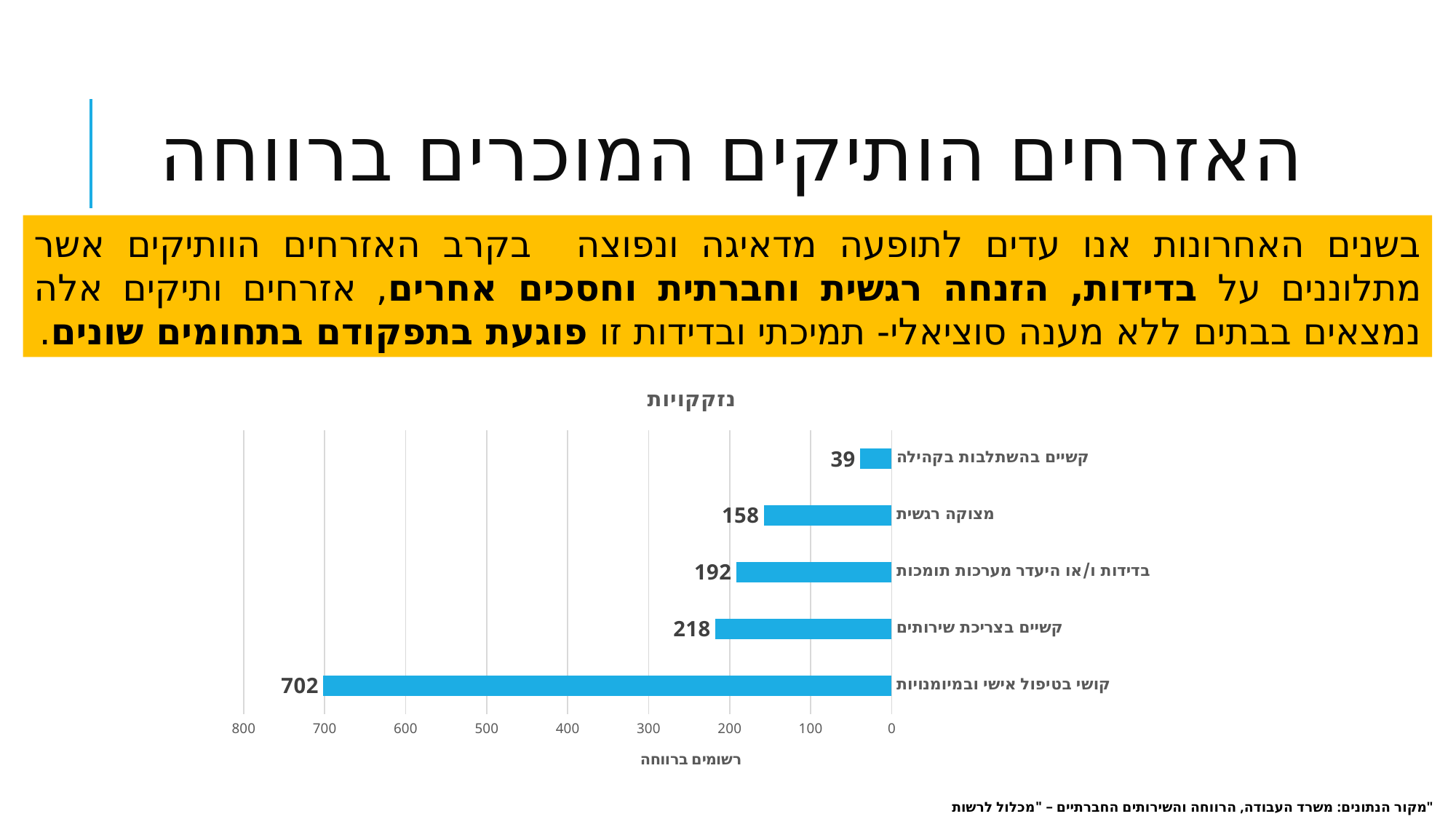
What is the title of the chart? נזקקויות What kind of chart is shown on the slide? bar chart What is the value for בדידות ו/או היעדר מערכות תומכות? 192 What is the value for קשיים בצריכת שירותים? 218 What is the difference between the values for קשיים בצריכת שירותים and מצוקה רגשית? 60 Which is larger: the value for בדידות ו/או היעדר מערכות תומכות or the value for מצוקה רגשית? בדידות ו/או היעדר מערכות תומכות Which category has the lowest value? קשיים בהשתלבות בקהילה What is the value for קושי בטיפול אישי ובמיומנויות? 702 How many categories are shown in the chart? 5 What is the value for מצוקה רגשית? 158 Which category has the highest value? קושי בטיפול אישי ובמיומנויות Is the value for קשיים בהשתלבות בקהילה greater or less than 100? less